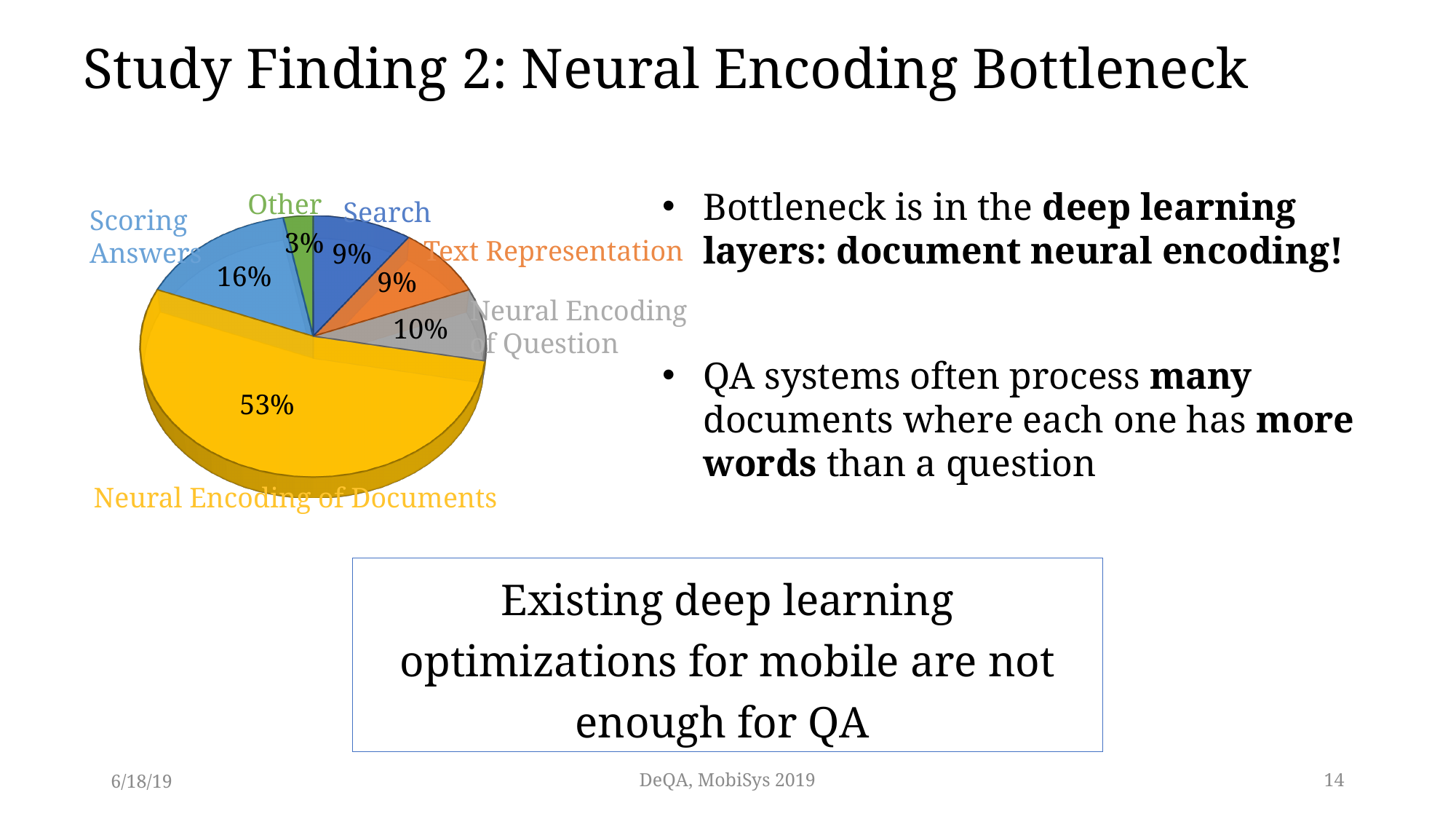
Which slice of the pie is the smallest? Other What is the difference in percentage points between Neural Encoding of Documents and Scoring Answers? 37 What share of the pie does Scoring Answers take? 16% Which slice of the pie is the largest? Neural Encoding of Documents What share of the pie does Neural Encoding of Question take? 10% Which is larger, the Scoring Answers slice or the Neural Encoding of Question slice? Scoring Answers What share of the pie does Neural Encoding of Documents take? 53% How many slices does the pie chart have? 6 What colour is the Neural Encoding of Documents slice? Yellow What kind of chart is shown on the slide? Pie chart What share of the pie does Search take? 9% What share of the pie does Other take? 3%